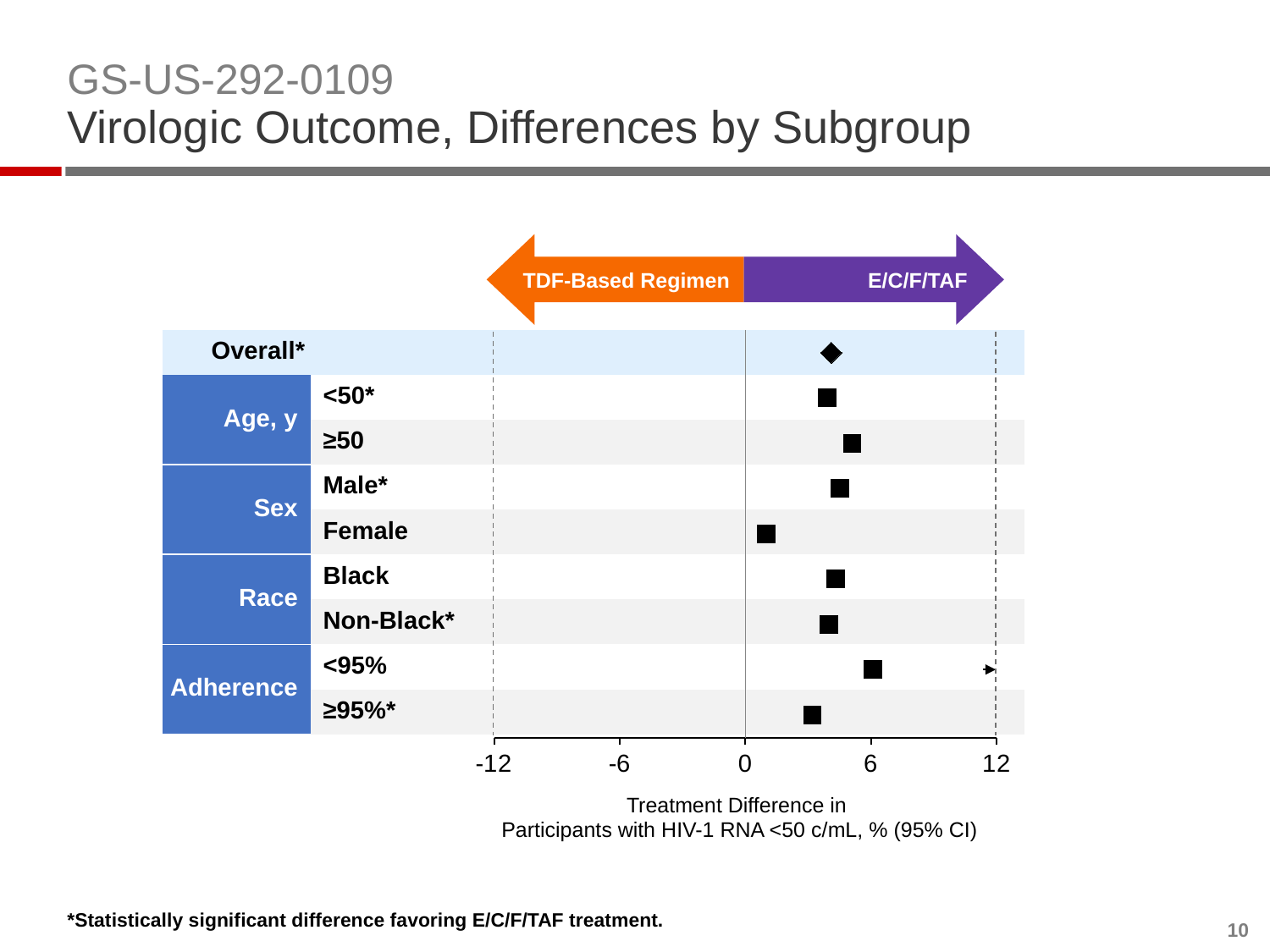
Which subgroup has the smallest treatment difference on the chart? Female Which subgroup has the largest treatment difference on the chart? Adherence <95% Which has the larger treatment difference, Male or Female? Male Is the treatment difference for Adherence <95% greater or less than 0? greater Is the treatment difference for Overall greater or less than 0? greater How many point estimates are plotted on the chart, including Overall? 9 Is the treatment difference for Female greater or less than 6? less Which treatment does the purple arrow pointing right favor? E/C/F/TAF Which has the larger treatment difference, Adherence <95% or Adherence ≥95%? Adherence <95% What kind of chart is shown on the slide? Forest plot What is the label of the horizontal axis? Treatment Difference in Participants with HIV-1 RNA <50 c/mL, % (95% CI)